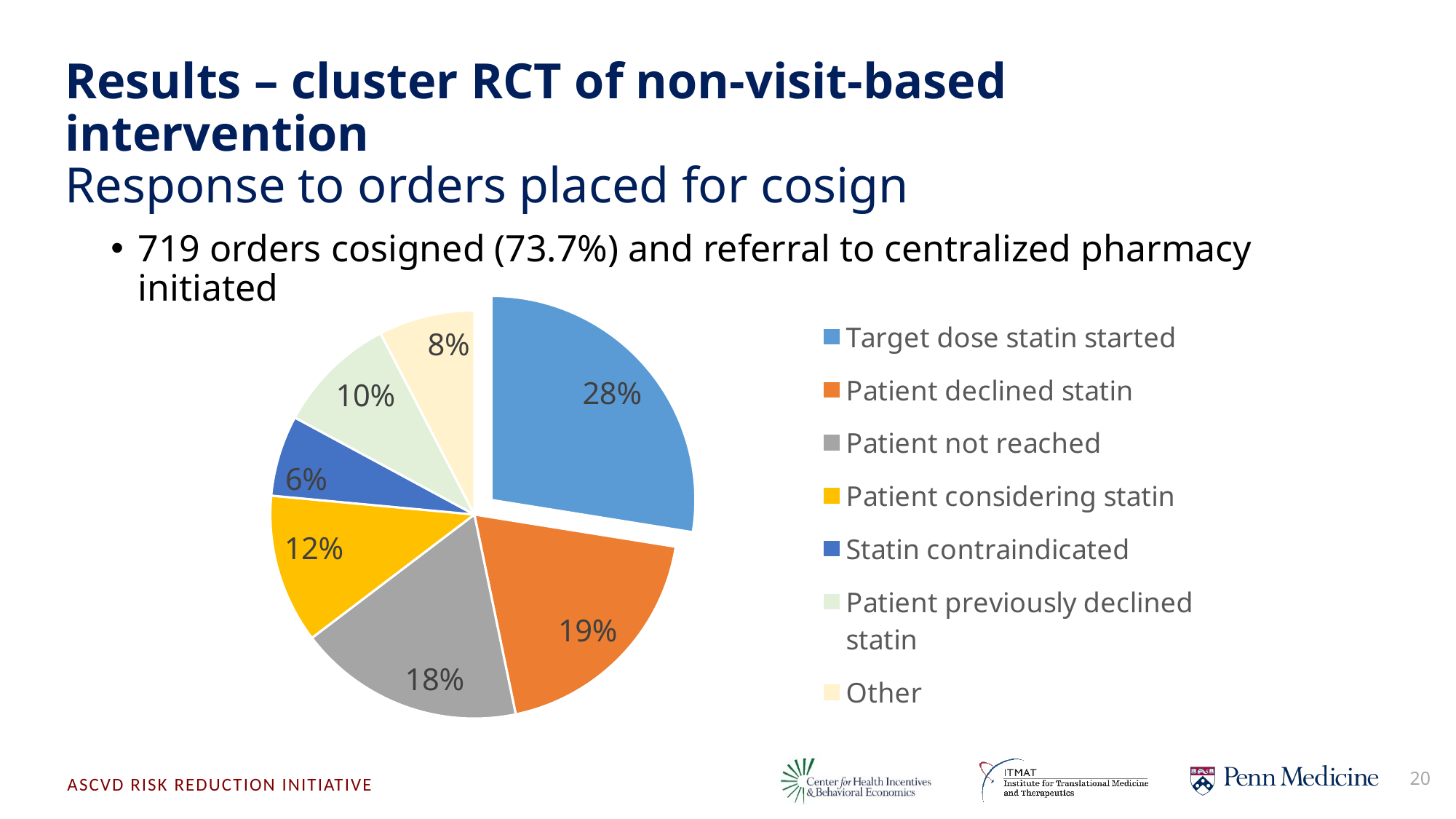
What share of the pie is labelled 'Statin contraindicated'? 6% How many categories does the legend of the pie chart list? 7 What is the difference in percentage points between 'Target dose statin started' and 'Patient declined statin'? 9 percentage points What share of the pie is labelled 'Other'? 8% Which category has the largest slice of the pie? Target dose statin started What share of the pie is labelled 'Target dose statin started'? 28% What share of the pie is labelled 'Patient considering statin'? 12% Which is larger: the slice for 'Patient previously declined statin' or the slice for 'Other'? Patient previously declined statin What share of the pie is labelled 'Patient declined statin'? 19% Which category has the smallest slice of the pie? Statin contraindicated What share of the pie is labelled 'Patient not reached'? 18% What kind of chart is shown on the slide? Pie chart